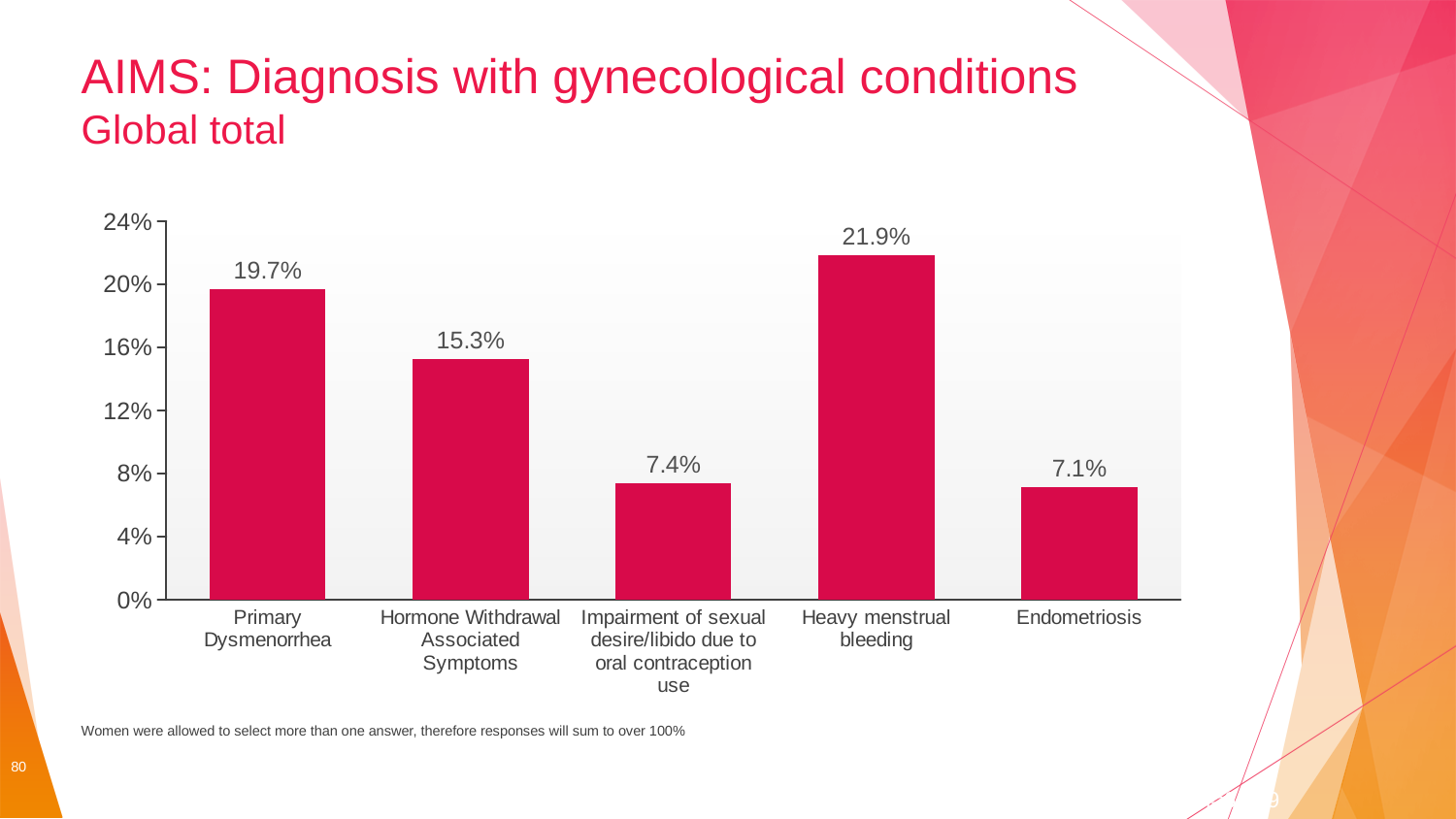
Is the value for Impairment of sexual desire/libido due to oral contraception use greater or less than 8%? less What type of chart is shown on the slide? Bar chart What is the difference between the values for Heavy menstrual bleeding and Primary Dysmenorrhea? 2.2% What is the value shown for Endometriosis? 7.1% What is the value shown for Heavy menstrual bleeding? 21.9% Which is larger: the value for Primary Dysmenorrhea or the value for Hormone Withdrawal Associated Symptoms? Primary Dysmenorrhea Which condition has the highest percentage? Heavy menstrual bleeding What is the value for Hormone Withdrawal Associated Symptoms? 15.3% What percentage of women reported a diagnosis of Primary Dysmenorrhea? 19.7% How many conditions are shown on the chart? 5 What is the difference between the values for Primary Dysmenorrhea and Hormone Withdrawal Associated Symptoms? 4.4% Which condition has the lowest percentage? Endometriosis